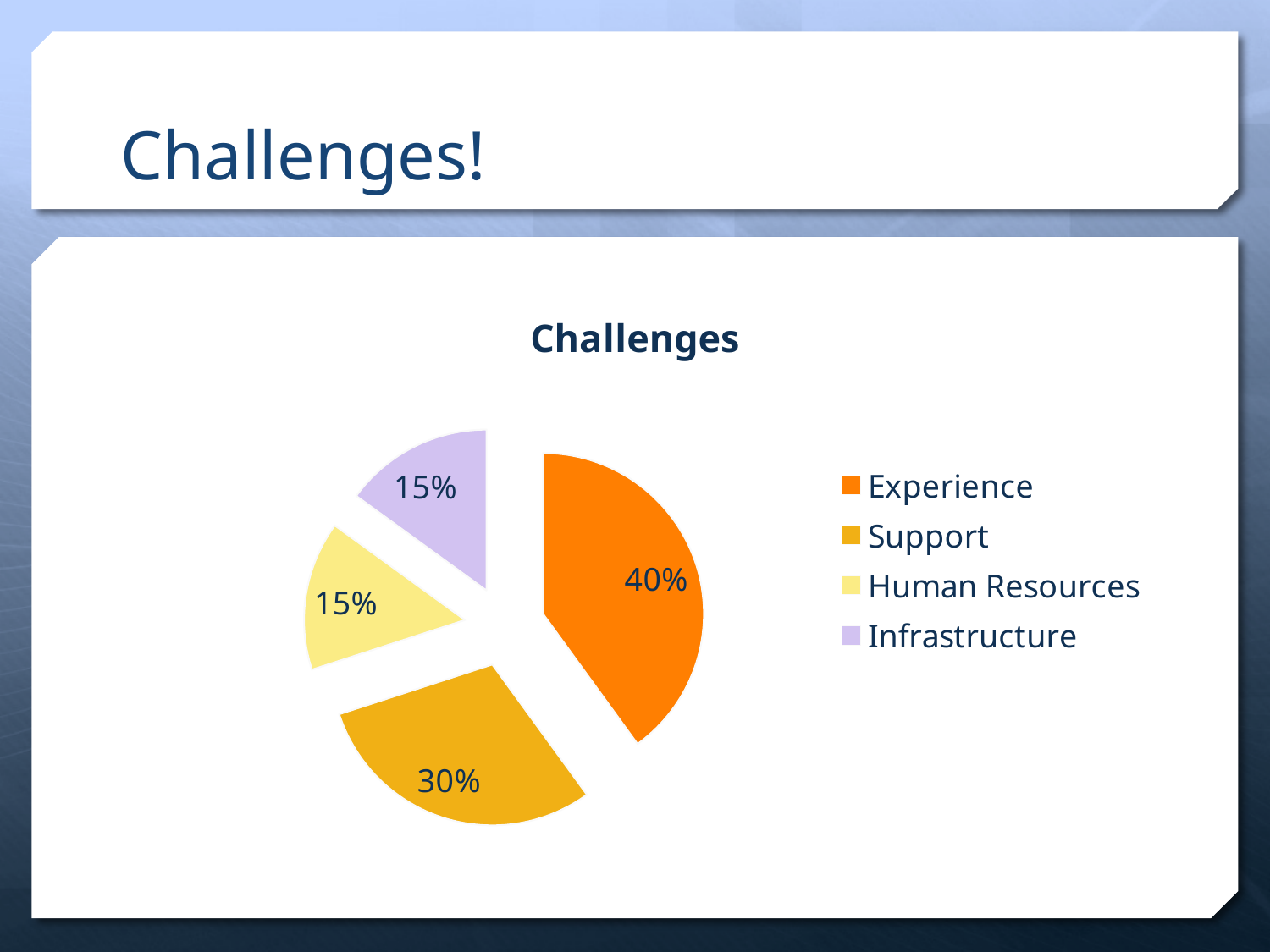
What share of the pie does Experience account for? 40% Which is larger, the Support slice or the Infrastructure slice? Support Which colour represents Infrastructure in the legend? Light purple What is the difference between the Experience and Support slices? 10% What is the value shown for Support? 30% What is the title of the chart? Challenges What is the combined share of Human Resources and Infrastructure? 30% What type of chart is shown on the slide? Pie chart What is the value shown for Infrastructure? 15% Which category has the largest slice of the pie? Experience What is the value shown for Human Resources? 15% How many categories are shown in the pie chart? 4